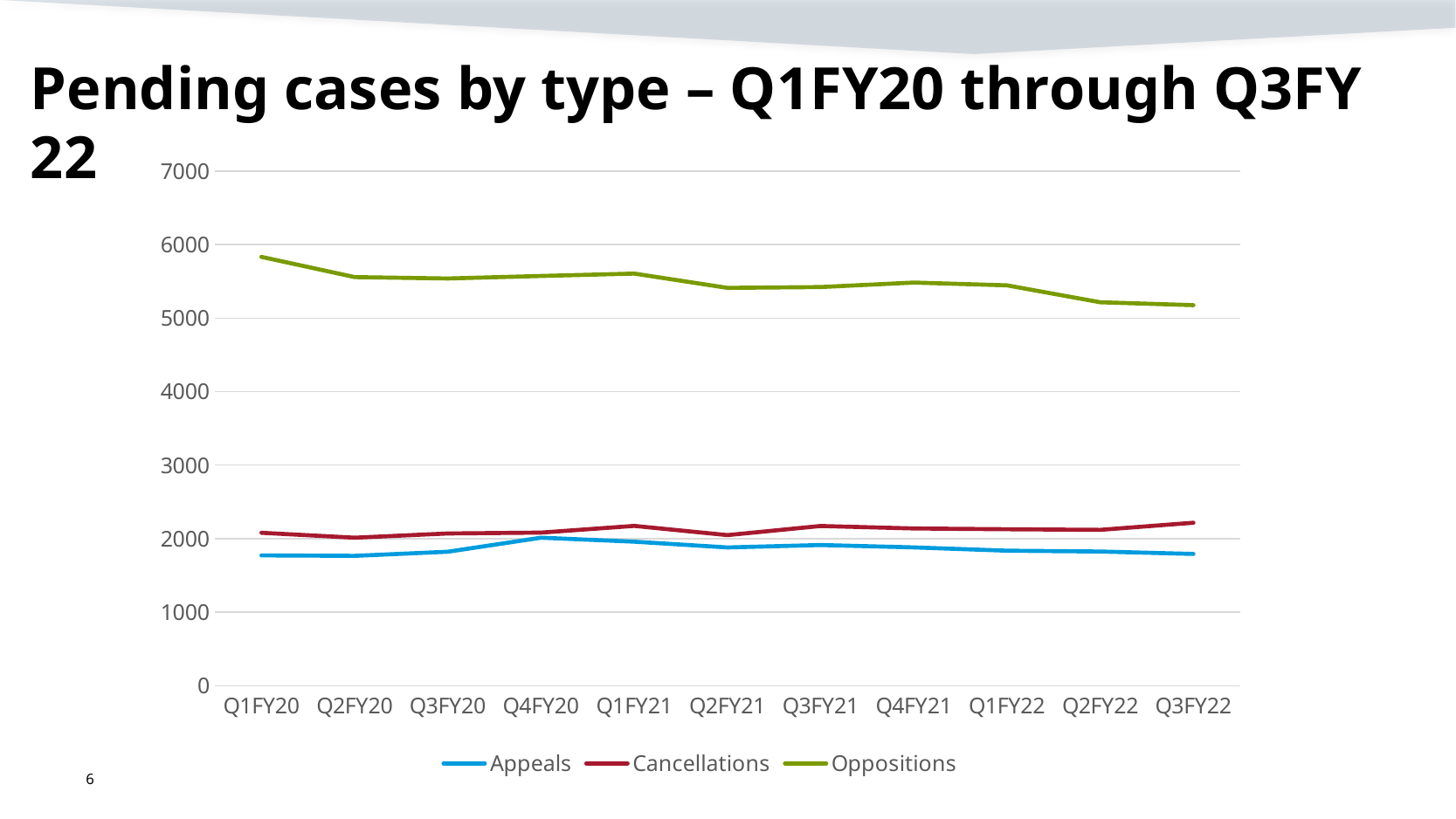
Which series has the lowest values across all quarters? Appeals Do the Oppositions values generally rise or fall from Q1FY20 to Q3FY22? fall Is the Oppositions value for Q3FY22 greater or less than 6000? less Is the Cancellations value for Q3FY22 greater or less than 2000? greater How many quarters are plotted along the x axis? 11 In which quarter is the Oppositions value highest? Q1FY20 How many series does the legend list? 3 Which series has the highest values across all quarters? Oppositions What kind of chart is shown on the slide? Line chart What is the title of the chart on the slide? Pending cases by type – Q1FY20 through Q3FY22 Is the Oppositions value for Q1FY20 greater or less than 5000? greater